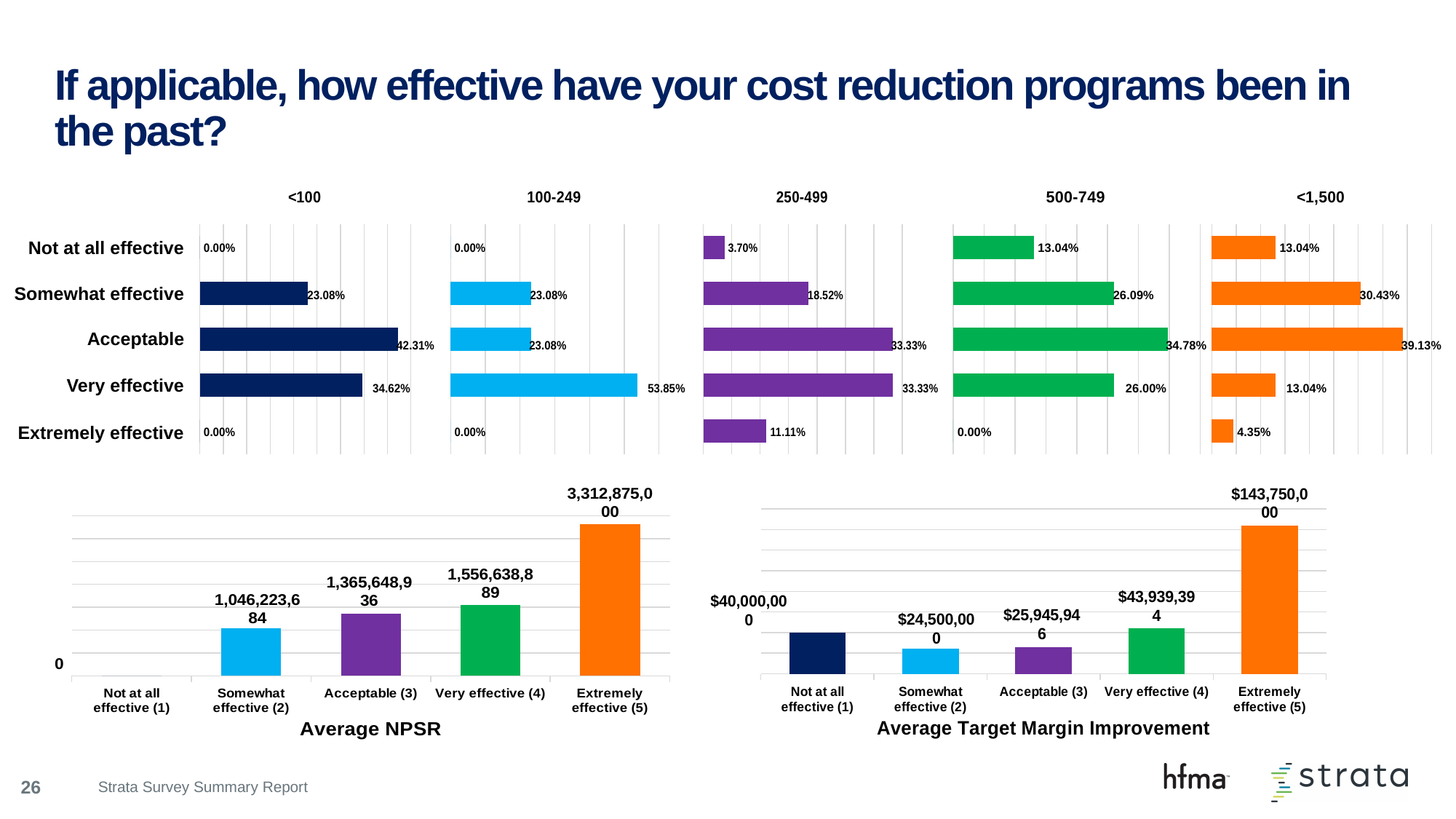
In the '100-249' chart, which category has the highest value? Very effective In the '<1,500' chart, which category has the highest value? Acceptable In the '500-749' chart, what is the difference between 'Acceptable' and 'Not at all effective'? 21.74% In the '<1,500' chart, which is larger: 'Somewhat effective' or 'Very effective'? Somewhat effective In the 'Average NPSR' chart, what is the value for 'Extremely effective (5)'? 3,312,875,000 In the '<100' chart, what is the value for 'Acceptable'? 42.31% In the 'Average Target Margin Improvement' chart, which category has the lowest value? Somewhat effective (2) In the 'Average Target Margin Improvement' chart, what is the value for 'Acceptable (3)'? $25,945,946 What kind of chart is the 'Average Target Margin Improvement' chart? Bar chart In the '100-249' chart, what is the value for 'Very effective'? 53.85% How many categories are shown in the 'Average NPSR' chart? 5 In the '250-499' chart, what is the value for 'Extremely effective'? 11.11%